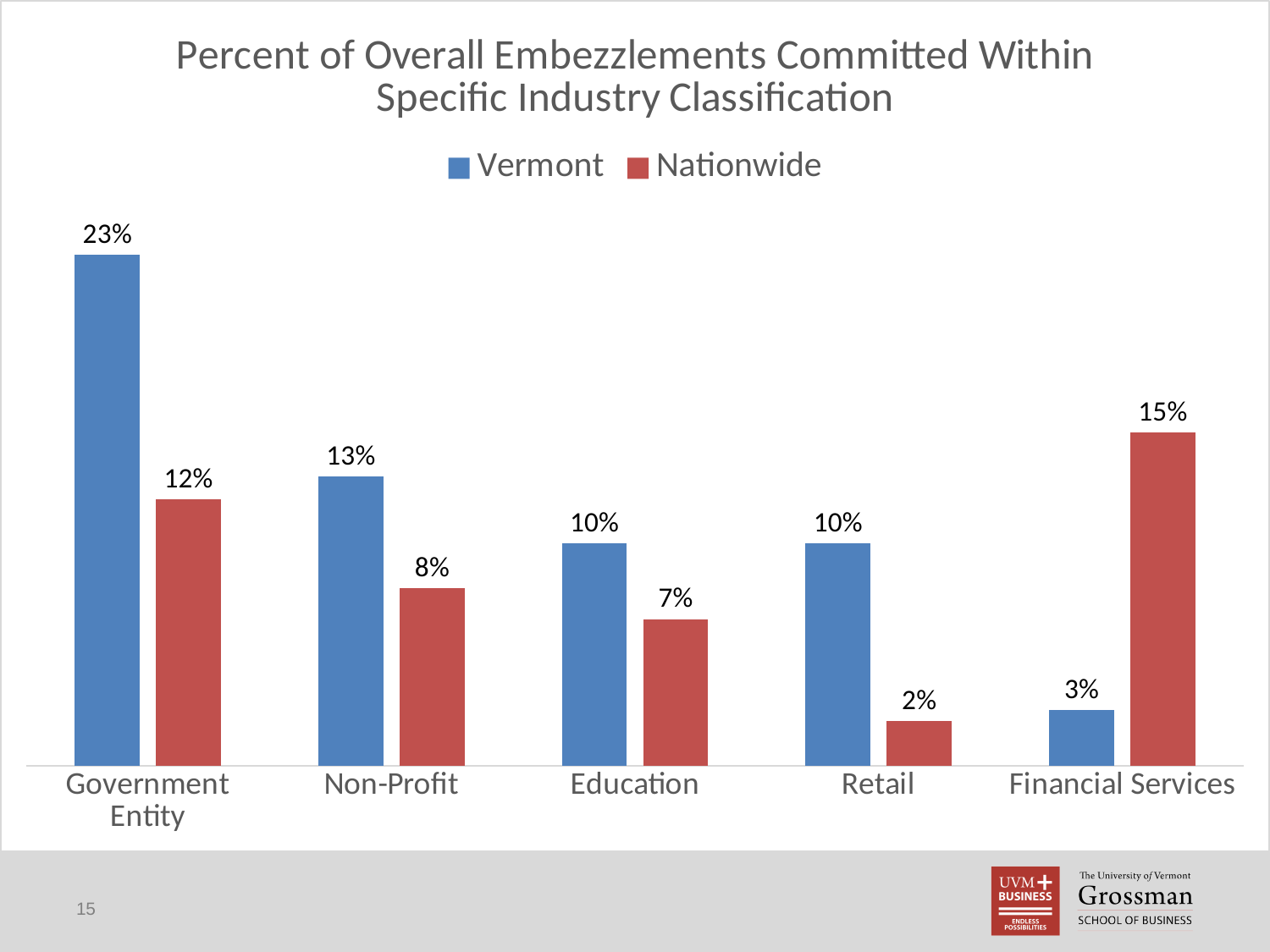
What colour represents the Nationwide series? Red What is the Nationwide value for Retail? 2% Which is larger for Financial Services, the Vermont value or the Nationwide value? Nationwide What is the Vermont value for Non-Profit? 13% What is the Vermont value for Government Entity? 23% Which category has the lowest Nationwide value? Retail How many series does the legend list? 2 What is the Nationwide value for Financial Services? 15% Which category has the highest Vermont value? Government Entity What kind of chart is shown on the slide? Bar chart How many industry categories are shown on the x axis? 5 What is the difference between the Vermont and Nationwide values for Government Entity? 11%